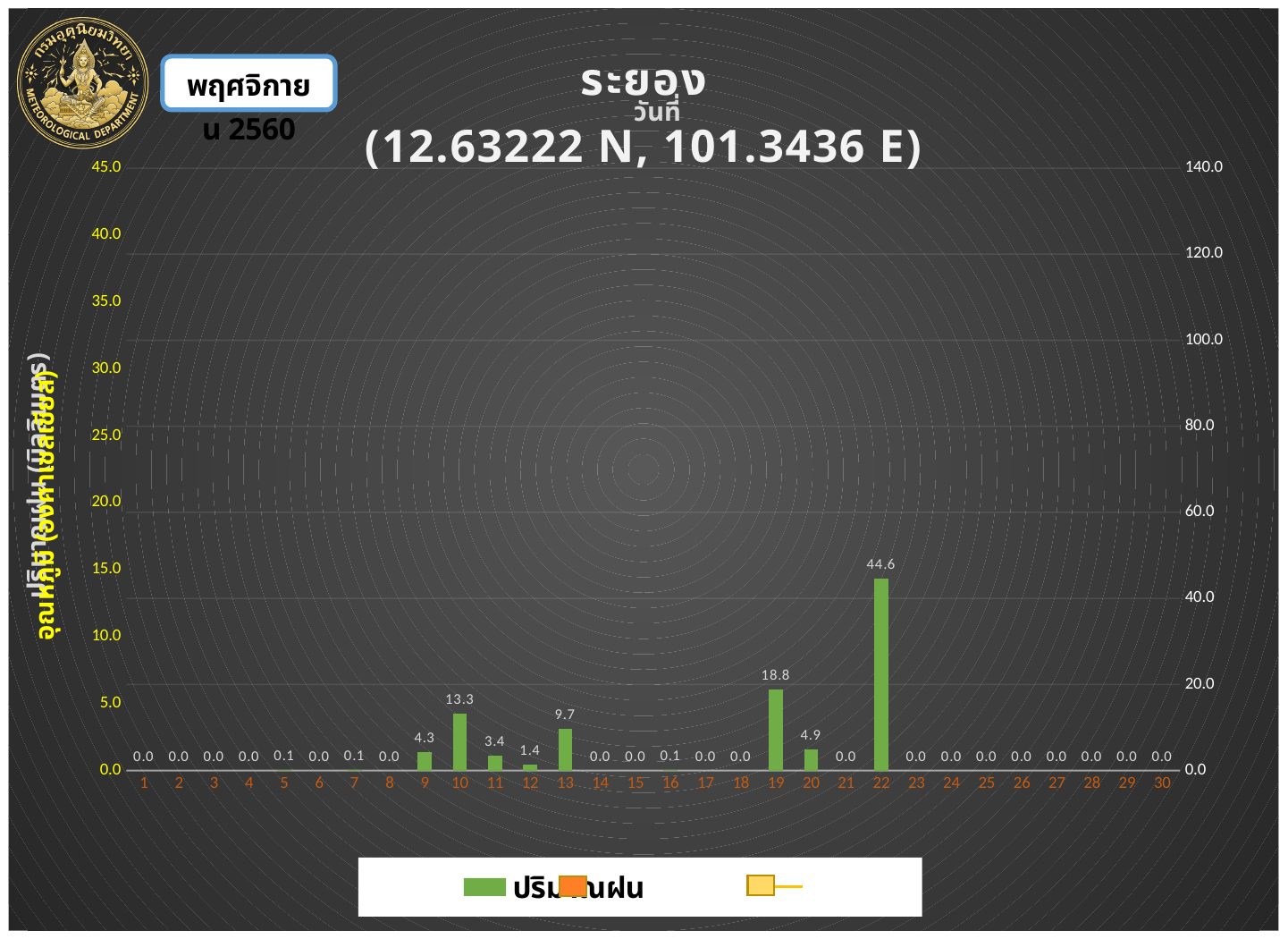
What kind of chart is shown on the slide? bar chart What is the value for day 13? 9.7 What is the value for day 22? 44.6 What is the difference between the values for day 10 and day 9? 9.0 Which day has the highest value? 22 What is the difference between the values for day 22 and day 19? 25.8 What is the value for day 10? 13.3 Which is larger, the value for day 13 or the value for day 20? day 13 Which is larger, the value for day 11 or the value for day 12? day 11 What is the value for day 19? 18.8 What are the coordinates shown in the chart title? 12.63222 N, 101.3436 E How many days are shown on the x axis? 30